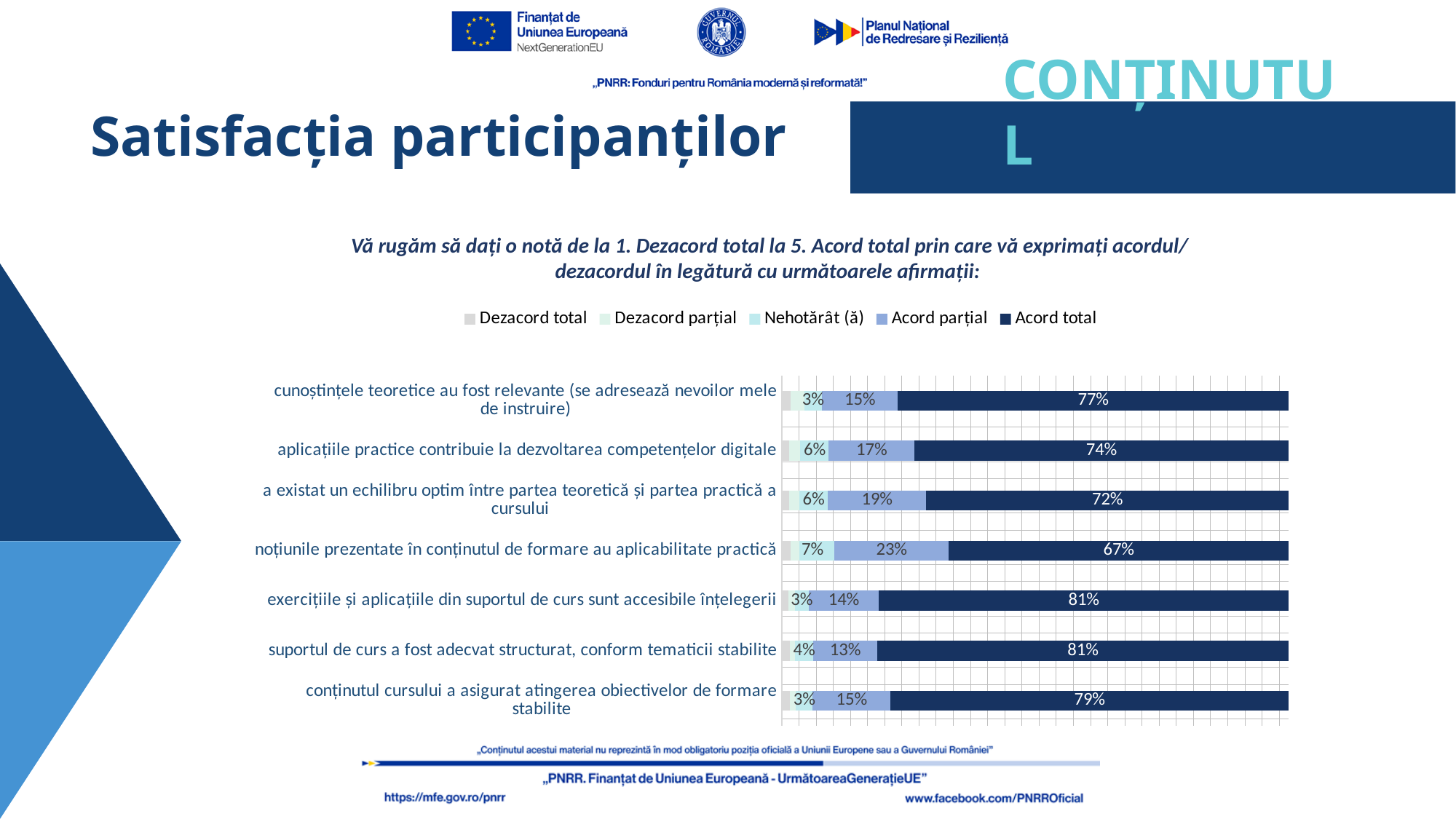
What is the "Acord parțial" value for "noțiunile prezentate în conținutul de formare au aplicabilitate practică"? 23% How many series does the legend list? 5 What percentage of participants chose "Acord total" for "cunoștințele teoretice au fost relevante (se adresează nevoilor mele de instruire)"? 77% Which statement has the lowest "Acord parțial" percentage? suportul de curs a fost adecvat structurat, conform tematicii stabilite How many statements (categories) are shown in the chart? 7 Which statement has the highest "Acord parțial" percentage? noțiunile prezentate în conținutul de formare au aplicabilitate practică What is the "Nehotărât (ă)" value for "aplicațiile practice contribuie la dezvoltarea competențelor digitale"? 6% Which statement has the lowest "Acord total" percentage? noțiunile prezentate în conținutul de formare au aplicabilitate practică What is the "Acord total" value for "conținutul cursului a asigurat atingerea obiectivelor de formare stabilite"? 79% What type of chart is shown on the slide? Stacked bar chart Which has a higher "Acord total" value: "aplicațiile practice contribuie la dezvoltarea competențelor digitale" or "a existat un echilibru optim între partea teoretică și partea practică a cursului"? aplicațiile practice contribuie la dezvoltarea competențelor digitale What is the difference in "Acord total" between "cunoștințele teoretice au fost relevante" and "noțiunile prezentate în conținutul de formare au aplicabilitate practică"? 10 percentage points